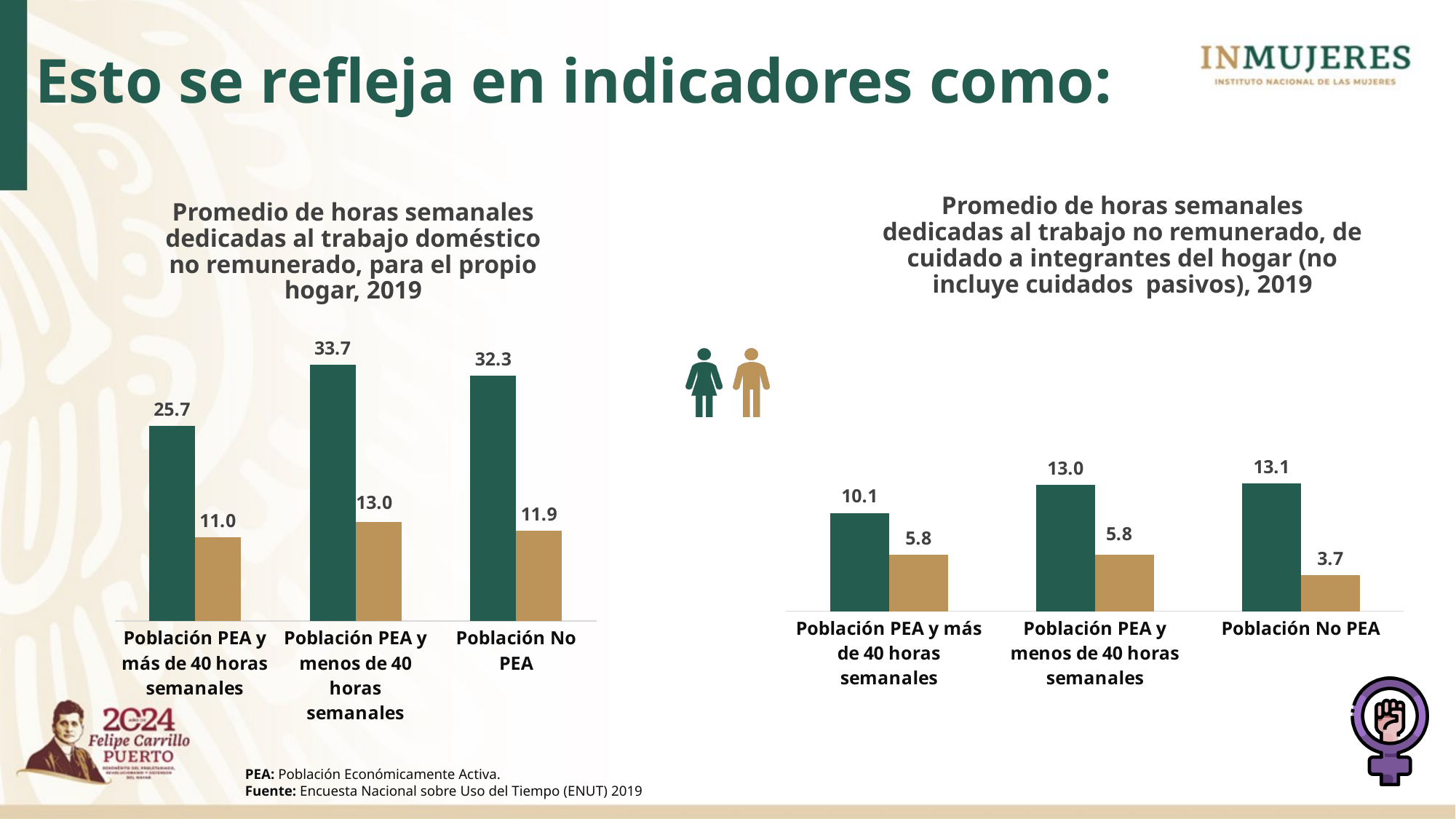
How many categories are shown on the x axis of the right chart (cuidado a integrantes del hogar)? 3 In the right chart (cuidado a integrantes del hogar), which category has the lowest tan bar? Población No PEA In the left chart (trabajo doméstico no remunerado), what is the value of the tan bar for Población No PEA? 11.9 In the left chart (trabajo doméstico no remunerado), which category has the highest green bar? Población PEA y menos de 40 horas semanales In the left chart (trabajo doméstico no remunerado), what is the difference between the green and tan bars for Población PEA y menos de 40 horas semanales? 20.7 In the left chart (trabajo doméstico no remunerado), what is the value of the green bar for Población PEA y más de 40 horas semanales? 25.7 In the right chart (cuidado a integrantes del hogar), what is the value of the green bar for Población PEA y más de 40 horas semanales? 10.1 In the right chart (cuidado a integrantes del hogar), what is the difference between the green and tan bars for Población No PEA? 9.4 What is the source cited at the bottom of the slide for the charts? Encuesta Nacional sobre Uso del Tiempo (ENUT) 2019 In the left chart (trabajo doméstico no remunerado), which is larger: the tan bar for Población PEA y menos de 40 horas semanales or the tan bar for Población PEA y más de 40 horas semanales? Población PEA y menos de 40 horas semanales What type of chart is the left chart (trabajo doméstico no remunerado)? Bar chart In the right chart (cuidado a integrantes del hogar), what is the value of the tan bar for Población No PEA? 3.7